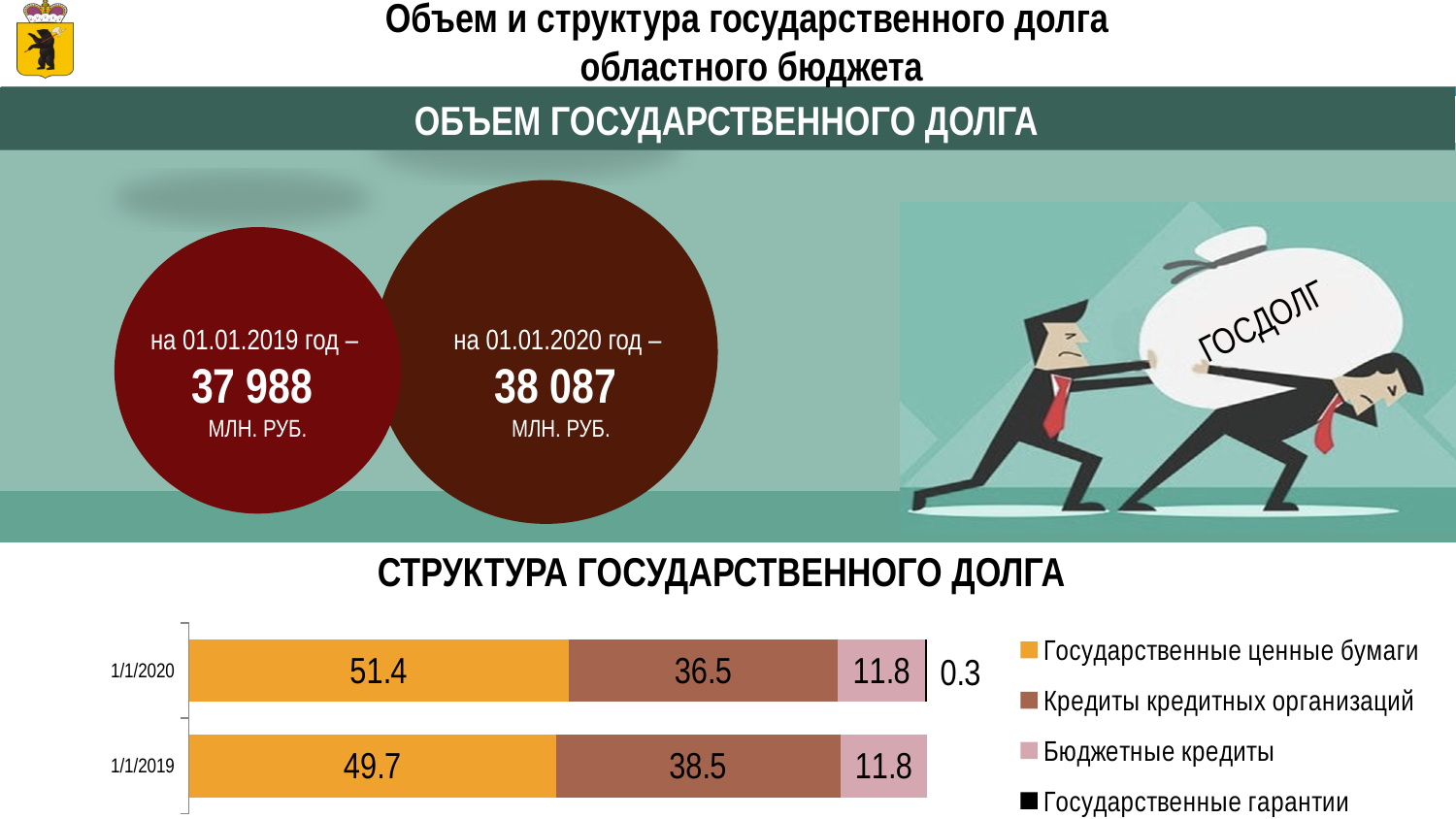
In the 'СТРУКТУРА ГОСУДАРСТВЕННОГО ДОЛГА' chart, what is the value for Государственные гарантии on 1/1/2020? 0.3 In the 'СТРУКТУРА ГОСУДАРСТВЕННОГО ДОЛГА' chart, which is larger on 1/1/2019: Государственные ценные бумаги or Кредиты кредитных организаций? Государственные ценные бумаги In the 'СТРУКТУРА ГОСУДАРСТВЕННОГО ДОЛГА' chart, what is the value for Бюджетные кредиты on 1/1/2020? 11.8 In the 'СТРУКТУРА ГОСУДАРСТВЕННОГО ДОЛГА' chart, which colour represents Бюджетные кредиты? Pink In the 'СТРУКТУРА ГОСУДАРСТВЕННОГО ДОЛГА' chart, how many dates (categories) are shown on the vertical axis? 2 In the 'СТРУКТУРА ГОСУДАРСТВЕННОГО ДОЛГА' chart, which series has the largest value on 1/1/2020? Государственные ценные бумаги In the 'СТРУКТУРА ГОСУДАРСТВЕННОГО ДОЛГА' chart, how many series does the legend list? 4 In the 'СТРУКТУРА ГОСУДАРСТВЕННОГО ДОЛГА' chart, what is the difference between Кредиты кредитных организаций on 1/1/2019 and on 1/1/2020? 2 In the 'СТРУКТУРА ГОСУДАРСТВЕННОГО ДОЛГА' chart, what is the value for Государственные ценные бумаги on 1/1/2020? 51.4 In the 'СТРУКТУРА ГОСУДАРСТВЕННОГО ДОЛГА' chart, by how much did the value for Государственные ценные бумаги change from 1/1/2019 to 1/1/2020? 1.7 What type of chart is shown under the heading 'СТРУКТУРА ГОСУДАРСТВЕННОГО ДОЛГА'? Stacked bar chart In the 'СТРУКТУРА ГОСУДАРСТВЕННОГО ДОЛГА' chart, what is the value for Кредиты кредитных организаций on 1/1/2019? 38.5